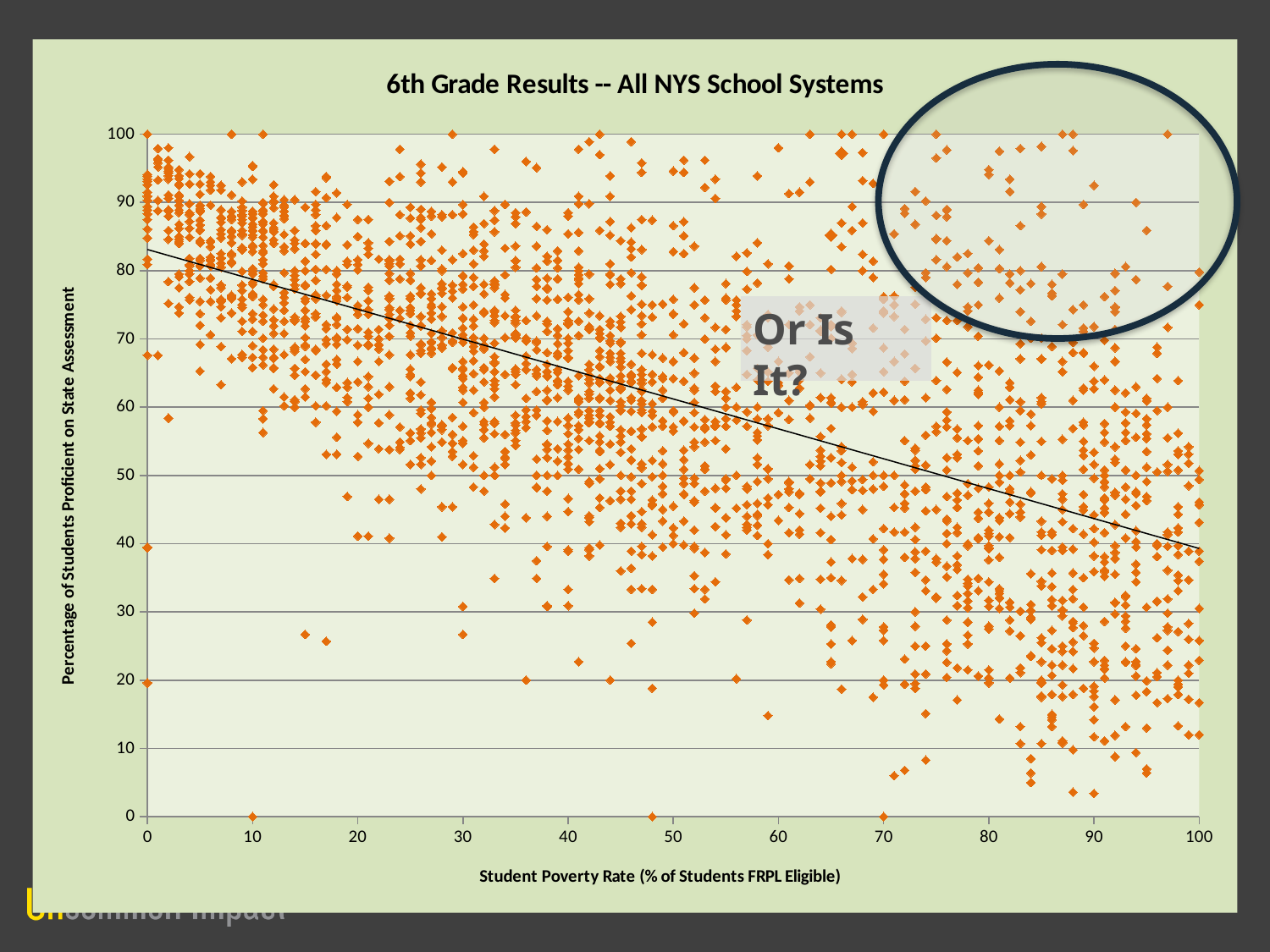
Is the trend line's value at a student poverty rate of 50 greater or less than 70? less Is the trend line's value at a student poverty rate of 20 greater or less than 60? greater What kind of chart is shown on the slide? Scatter chart Is the trend line's value at a student poverty rate of 0 greater or less than 70? greater As the student poverty rate increases along the x axis, does the trend line rise or fall? Fall What is the label of the x axis? Student Poverty Rate (% of Students FRPL Eligible) What is the title of the chart? 6th Grade Results -- All NYS School Systems